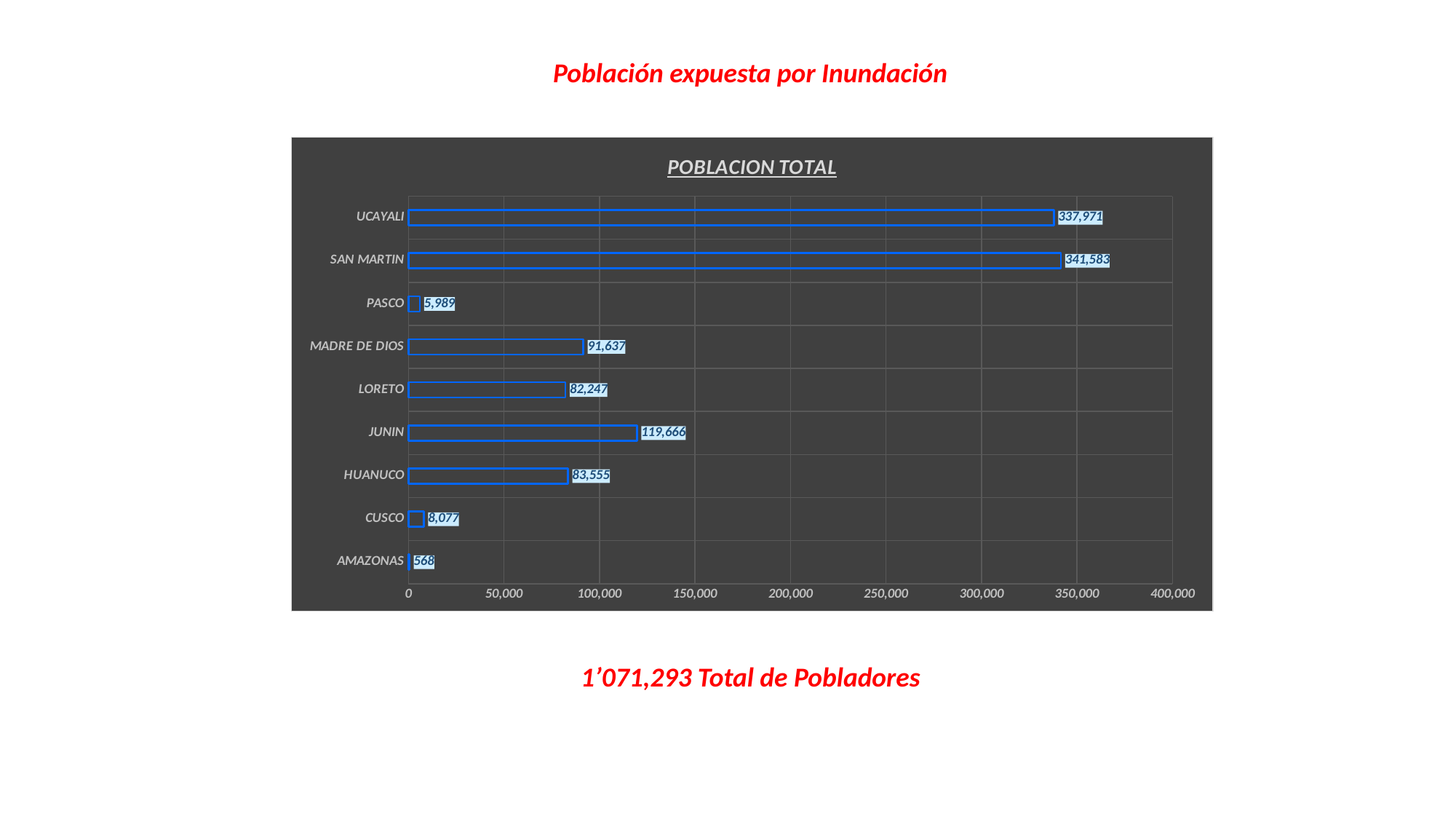
What kind of chart is shown on the slide? bar chart How many categories are shown in the chart? 9 What is the value for JUNIN in the POBLACION TOTAL chart? 119,666 Is the value for JUNIN greater or less than 100,000? greater What is the value for MADRE DE DIOS? 91,637 Which category has the lowest value? AMAZONAS What is the value for AMAZONAS? 568 What is the difference between the values for SAN MARTIN and UCAYALI? 3,612 What is the difference between the values for JUNIN and LORETO? 37,419 Which category has the highest value? SAN MARTIN Which is larger, the value for HUANUCO or the value for LORETO? HUANUCO What is the title of the chart? POBLACION TOTAL